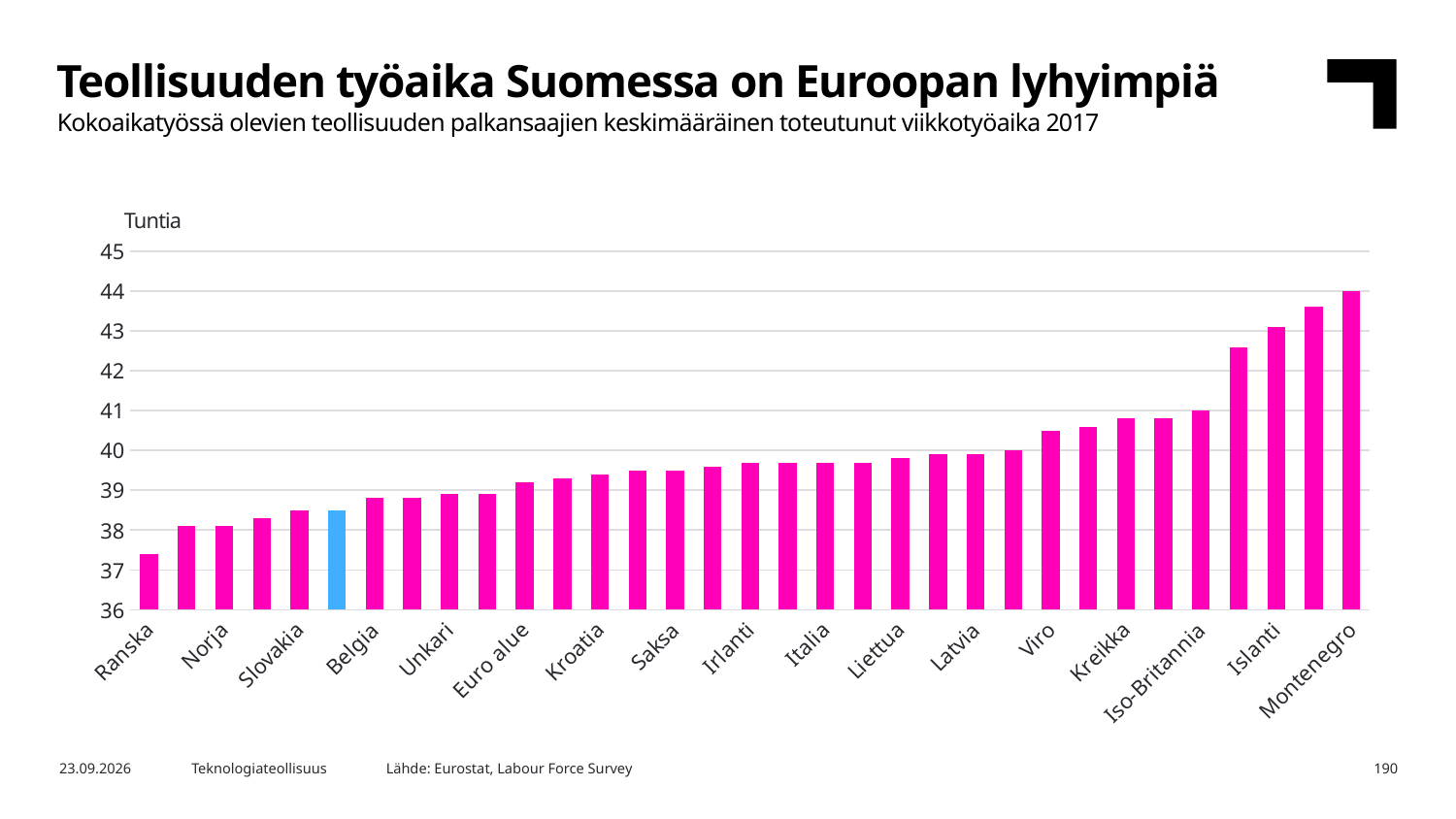
Which country has the highest average weekly working time in the chart? Montenegro What kind of chart is shown on the slide? bar chart Is the value for Viro greater or less than 40? greater What unit is shown on the vertical axis of the chart? Tuntia Is the value for Belgia greater or less than 39? less Is the value for Montenegro greater or less than 43? greater Which has the larger value, Montenegro or Islanti? Montenegro Which country has the lowest average weekly working time in the chart? Ranska Do the bar values rise or fall from left to right along the x axis? rise Which has the larger value, Ranska or Norja? Norja